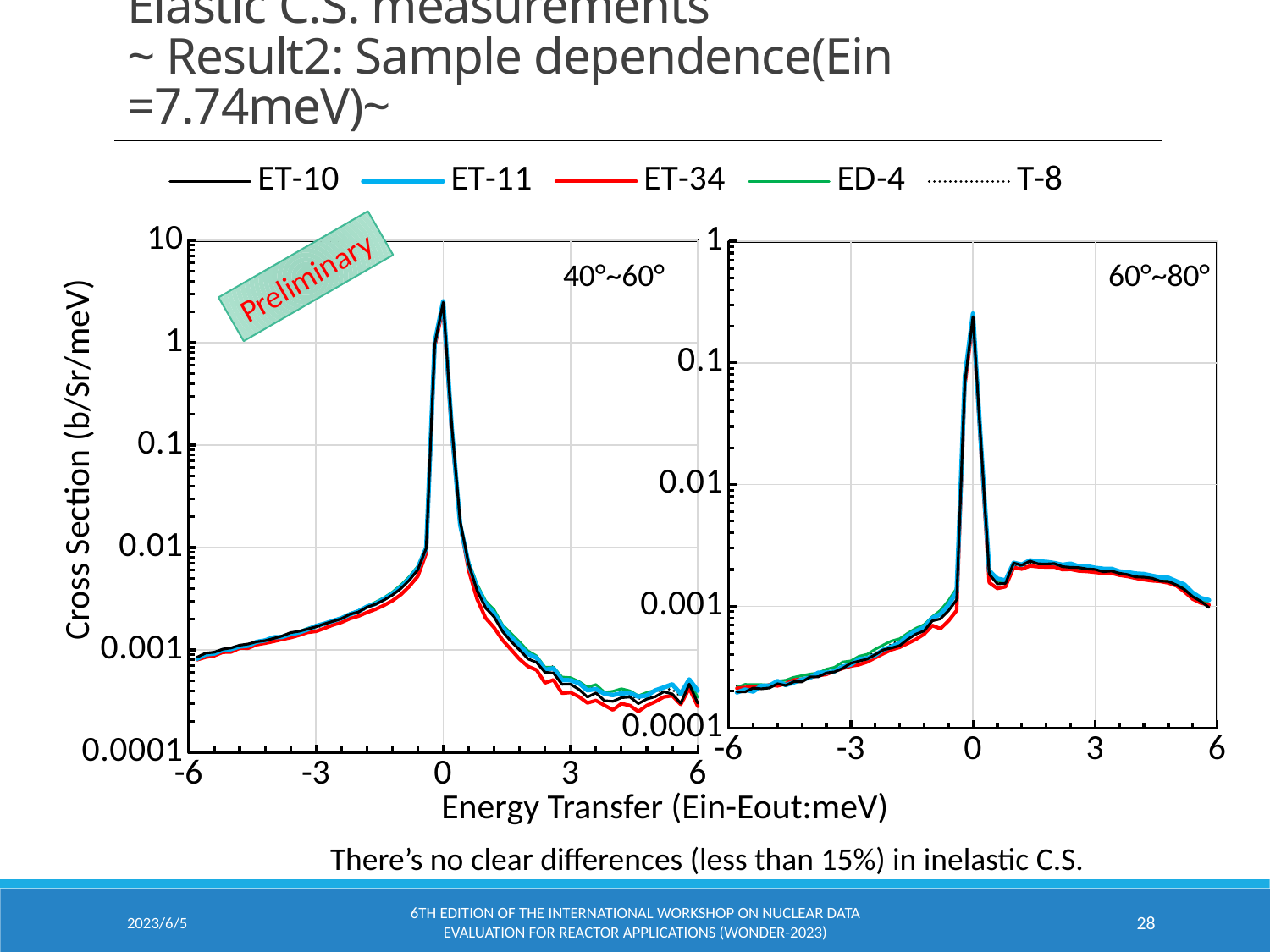
What is the x-axis label shared by the two charts? Energy Transfer (Ein-Eout:meV) In the left chart (40°~60°), is the value at an energy transfer of -6 greater or less than 0.001? less In the right chart (60°~80°), do the values rise or fall as the energy transfer goes from 3 to 6? fall In the left chart (40°~60°), at which energy transfer value do the curves reach their maximum? 0 In the right chart (60°~80°), is the value at an energy transfer of -6 greater or less than 0.001? less In the right chart (60°~80°), is the peak value at an energy transfer of 0 greater or less than 0.1? greater What is the y-axis label of the left chart? Cross Section (b/Sr/meV) In the left chart (40°~60°), do the values rise or fall as the energy transfer goes from -6 to 0? rise What kind of chart is the left chart (40°~60°)? line chart How many series does the legend list? 5